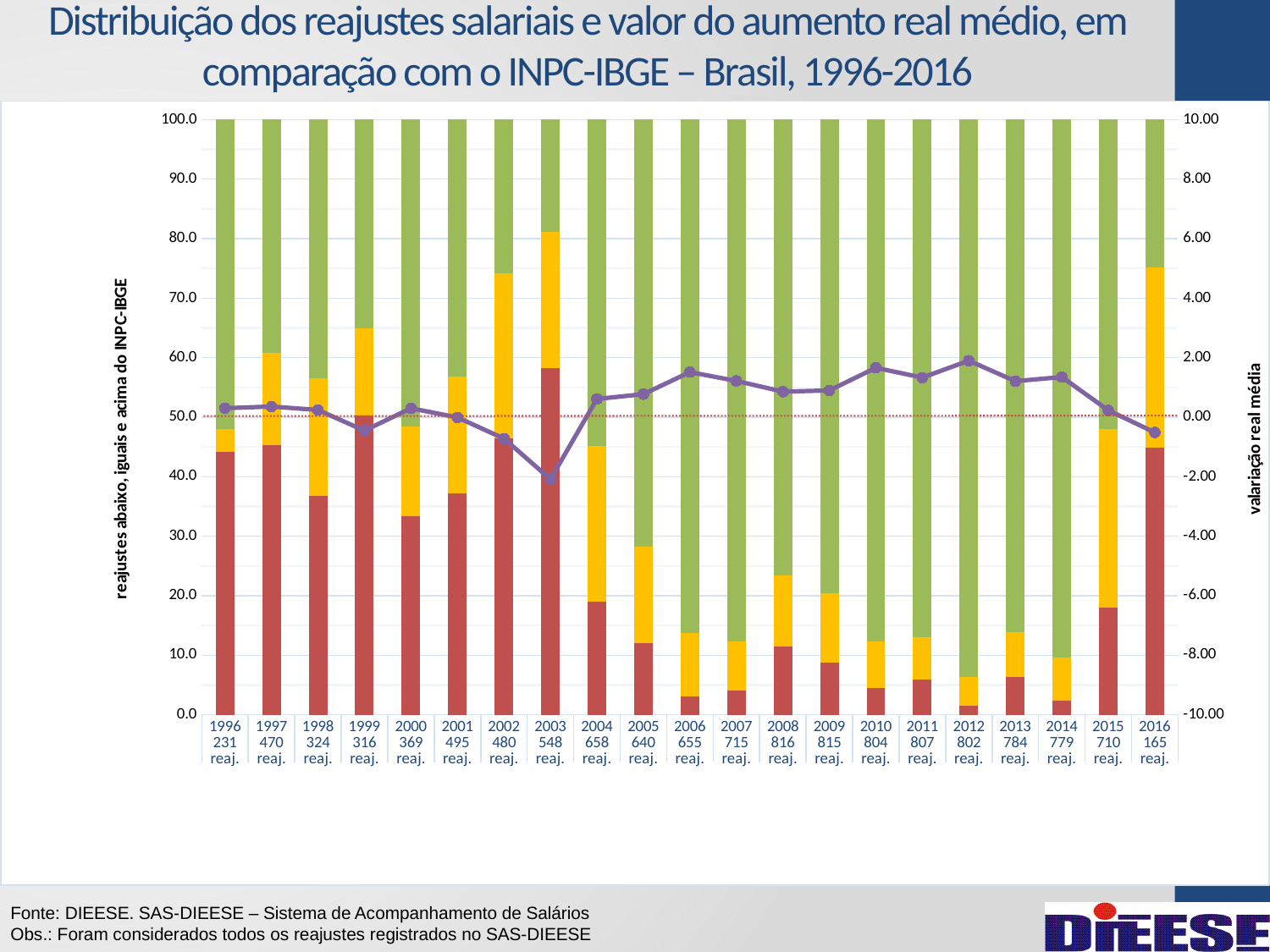
Which year has the lowest number of reajustes shown in the x-axis labels? 2016 Which year has the highest number of reajustes shown in the x-axis labels? 2008 Is the red (bottom) segment of the bar for 2003 greater or less than 50.0 on the left axis? greater What is the label of the right-hand vertical axis? valariação real média How many years (categories) are shown along the x axis? 21 What is the difference between the number of reajustes in 2015 and in 2016, as printed on the x-axis labels? 545 Is the line value for 2003 greater or less than 0.00 on the right axis? less What kind of chart is shown on the slide? Stacked bar chart with a line Is the red (bottom) segment of the bar for 2012 greater or less than 10.0 on the left axis? less Which year has a larger red (bottom) bar segment, 2003 or 2012? 2003 According to the x-axis labels, how many reajustes were recorded in 2008? 816 reaj. According to the x-axis labels, how many reajustes were recorded in 2016? 165 reaj.